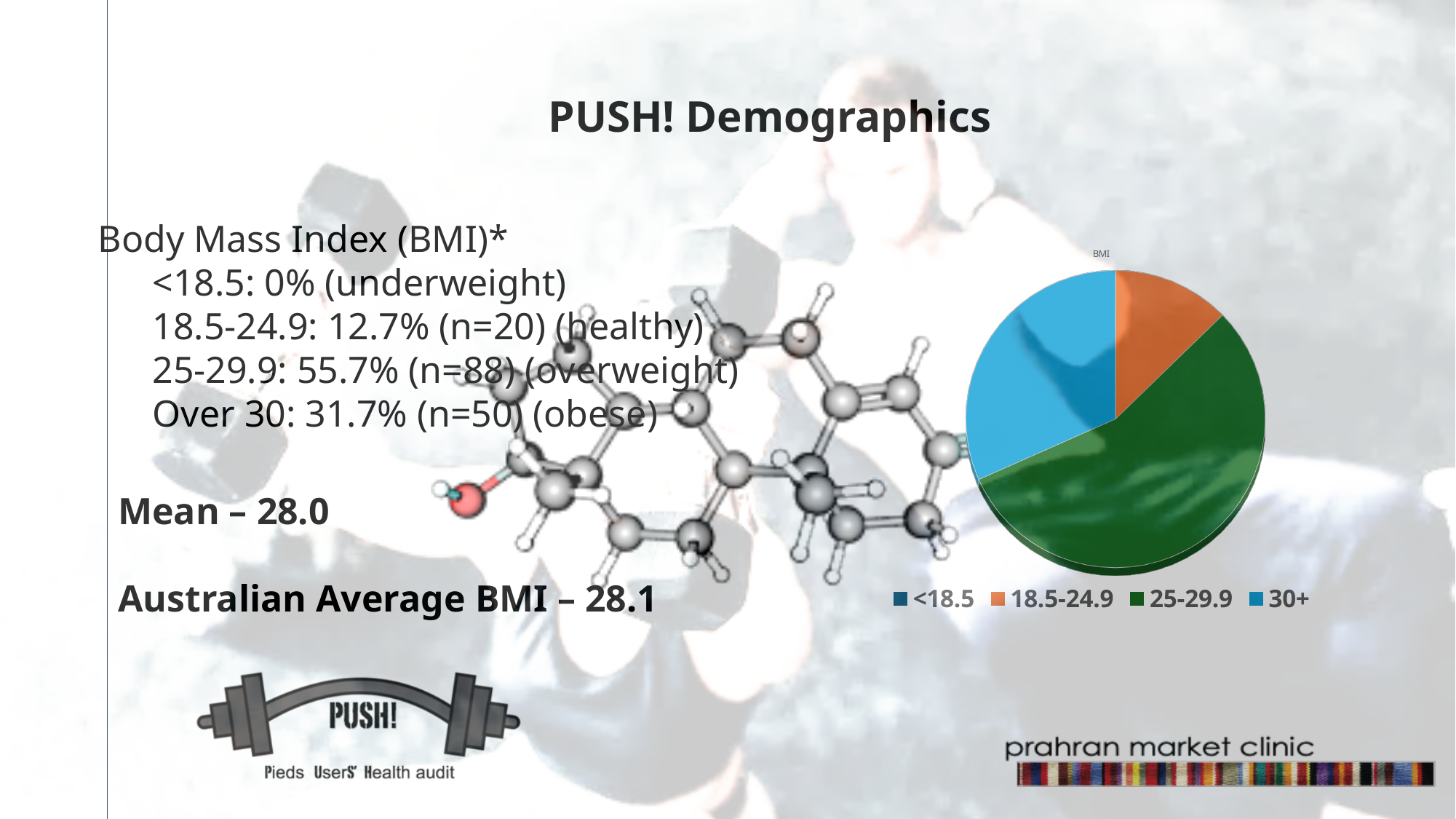
What is the title of the pie chart? BMI According to the slide, what share of the pie chart is the 30+ BMI category? 31.7% Which BMI category has the smallest share of the pie chart? <18.5 Which BMI category has the largest slice of the pie chart? 25-29.9 According to the slide, what share of the pie chart is the 25-29.9 BMI category? 55.7% According to the slide, what percentage is the <18.5 BMI category? 0% What colour is the 25-29.9 slice in the pie chart? dark green According to the slide, what share of the pie chart is the 18.5-24.9 BMI category? 12.7% What kind of chart is shown on the slide? pie chart What is the difference in percentage between the 25-29.9 and 30+ BMI categories shown on the slide? 24.0% How many categories does the pie chart's legend list? 4 Which slice is larger in the pie chart, 30+ or 18.5-24.9? 30+